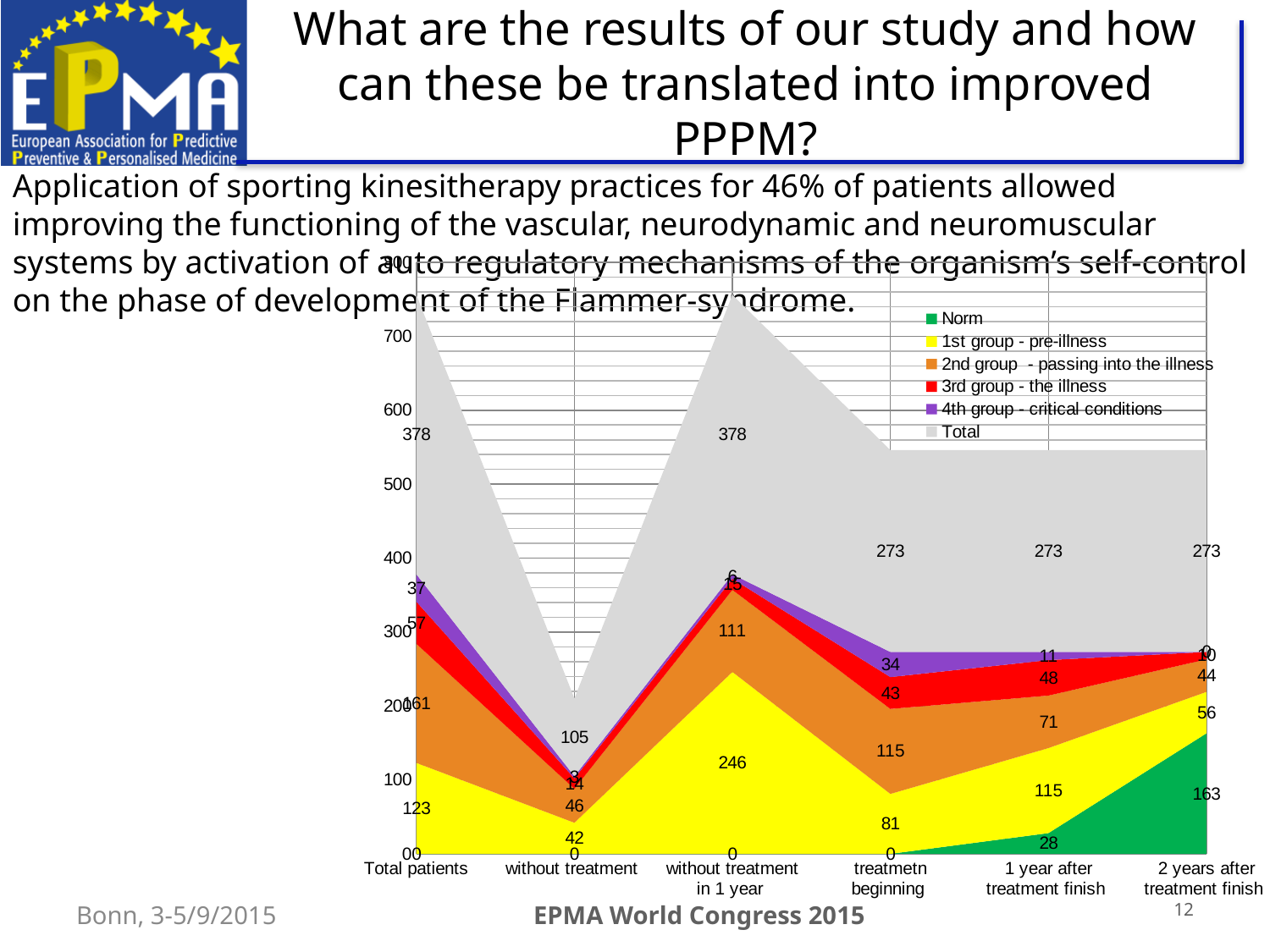
How many series does the legend list? 6 What kind of chart is shown on the slide? area chart How many categories are shown along the x axis? 6 What is the Total value for the 'without treatment' category? 105 What is the value of the 1st group - pre-illness series for the 'without treatment in 1 year' category? 246 What is the value of the Norm series for '2 years after treatment finish'? 163 For which category is the Total value lowest? without treatment What is the value of the 2nd group - passing into the illness series for 'Total patients'? 161 Which series is shown in green in the legend? Norm What is the difference between the Norm values for '2 years after treatment finish' and '1 year after treatment finish'? 135 Which is larger: the 3rd group - the illness value for 'Total patients' or for '1 year after treatment finish'? Total patients For which category is the 1st group - pre-illness value highest? without treatment in 1 year